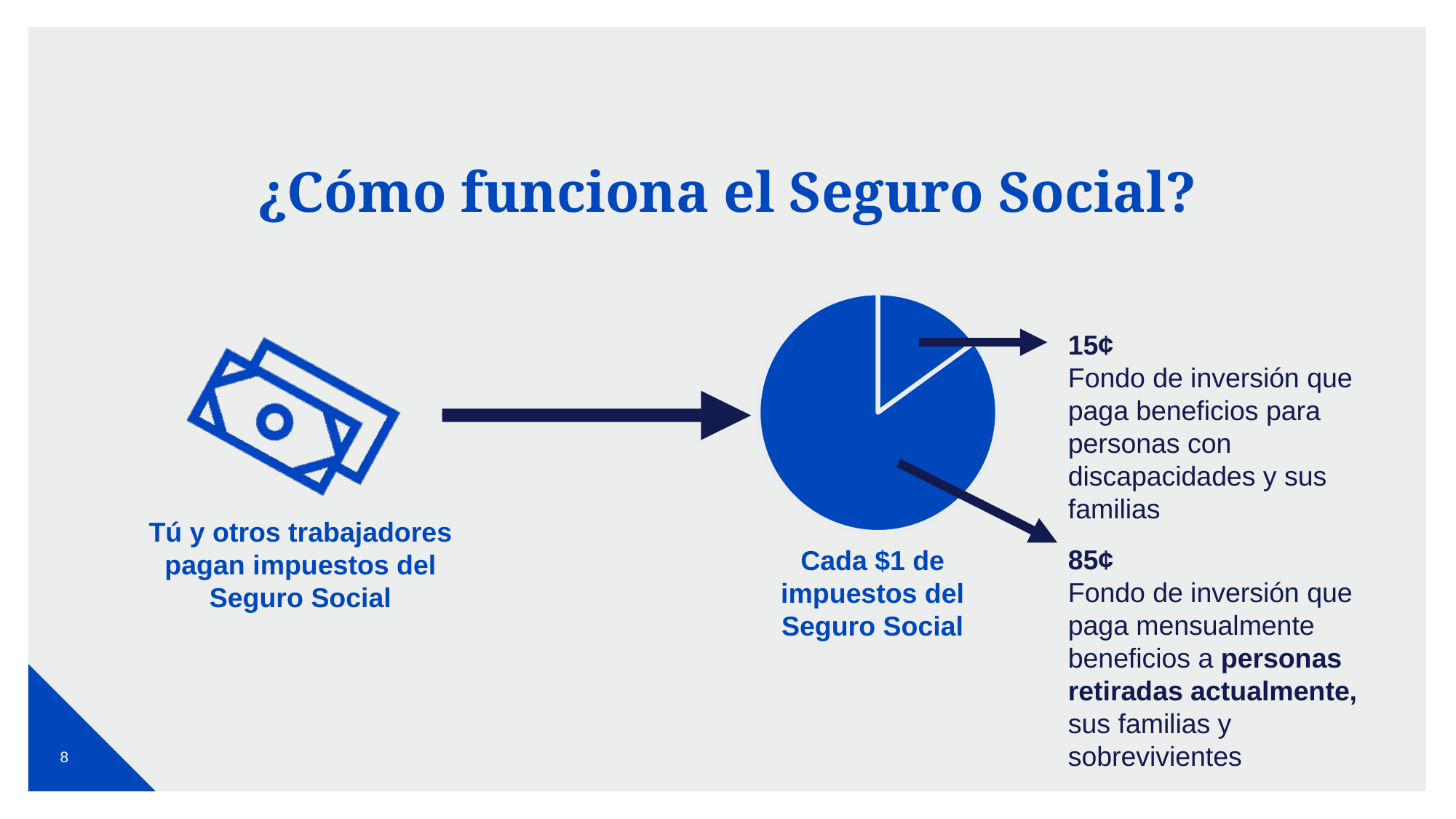
How many slices does the pie chart have? 2 Which slice of the pie chart is the largest? 85¢ (fund paying benefits to retired people, their families and survivors) Which slice of the pie chart is the smallest? 15¢ (fund paying benefits for people with disabilities and their families) What is the title of the slide containing the pie chart? ¿Cómo funciona el Seguro Social? How much of each $1 of Social Security taxes goes to the fund that pays benefits for people with disabilities and their families? 15¢ Which is larger: the share going to the disability fund or the share going to the retirement fund? the retirement fund (85¢) What kind of chart is shown on the slide? pie chart What is the label printed beneath the pie chart? Cada $1 de impuestos del Seguro Social What is the difference between the 85¢ slice and the 15¢ slice? 70¢ What do the two slices of the pie chart add up to? $1 How much of each $1 of Social Security taxes goes to the fund that pays monthly benefits to currently retired people, their families and survivors? 85¢